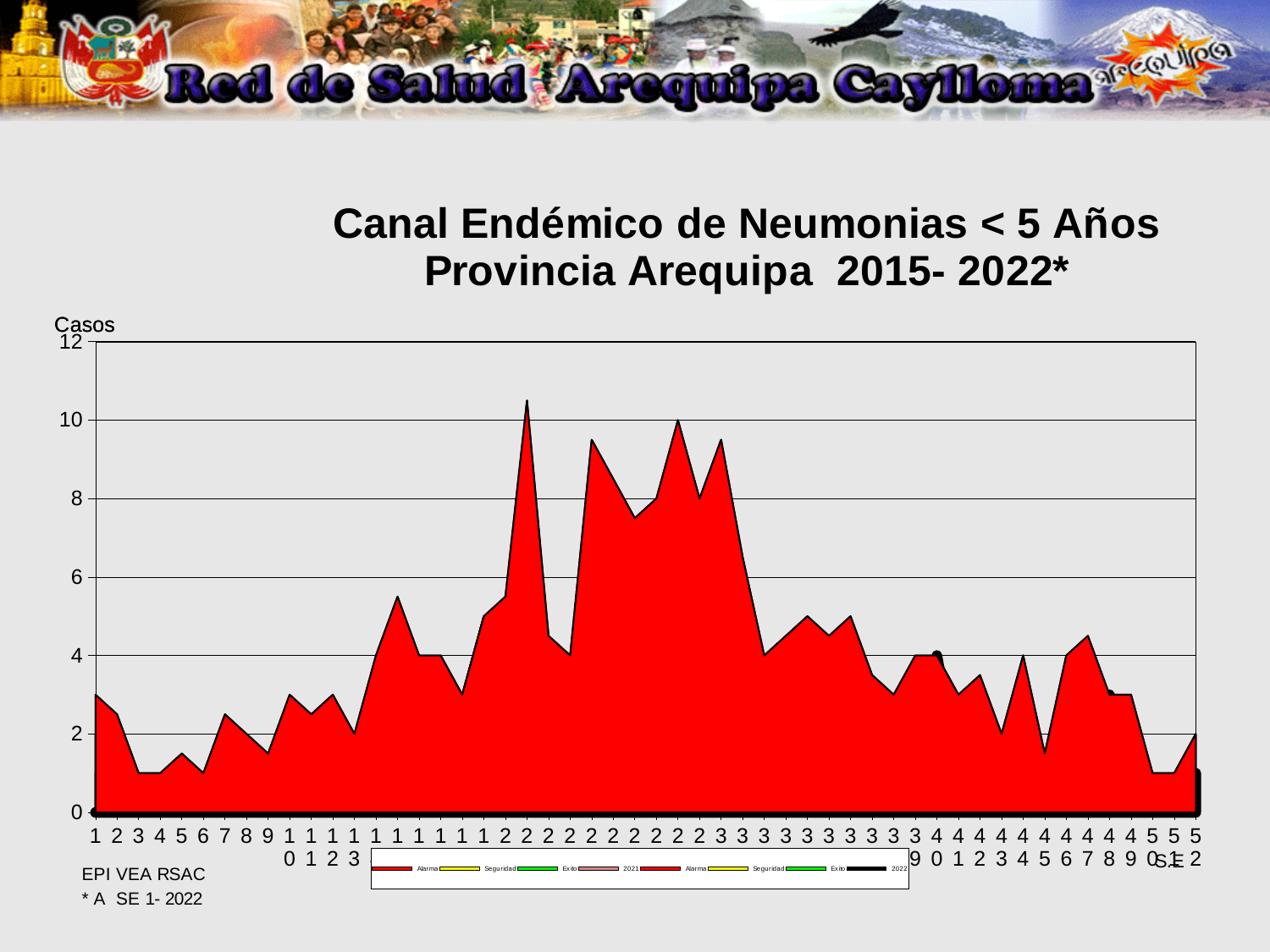
Which is larger, the value for week 22 or the value for week 40? week 22 How many weeks are labelled along the horizontal axis? 52 What kind of chart is shown on the slide? Area chart Is the value for week 1 greater or less than 4? less Is the value for week 26 greater or less than 8? less Between week 31 and week 50, do the values generally rise or fall? fall Is the value for week 22 greater or less than 10? less What is the title of the chart? Canal Endémico de Neumonias < 5 Años Provincia Arequipa 2015- 2022* What is the highest value shown on the vertical axis? 12 What label is shown on the vertical axis of the chart? Casos